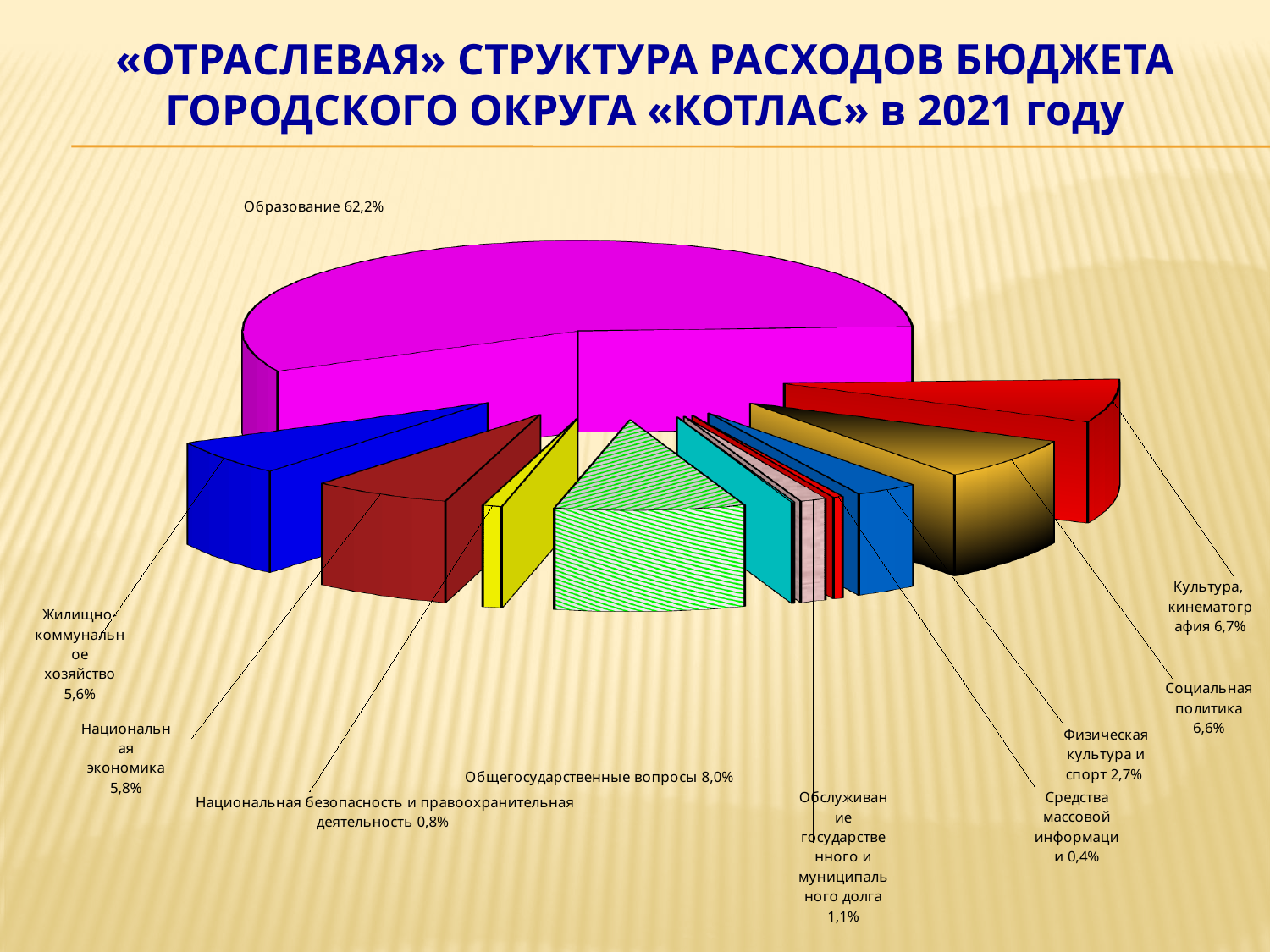
What type of chart is shown on the slide? Pie chart What is the value shown for Социальная политика? 6,6% Which is larger: Культура, кинематография or Социальная политика? Культура, кинематография What is the value shown for Общегосударственные вопросы? 8,0% Which category has the smallest share of the pie? Средства массовой информации Which year does the chart title refer to? 2021 What is the difference in percentage points between Общегосударственные вопросы and Физическая культура и спорт? 5,3 Which category has the largest share of the pie? Образование What is the value shown for Обслуживание государственного и муниципального долга? 1,1% What share of budget expenditure does Образование account for? 62,2% What is the difference in percentage points between Национальная экономика and Жилищно-коммунальное хозяйство? 0,2 What is the value shown for Средства массовой информации? 0,4%